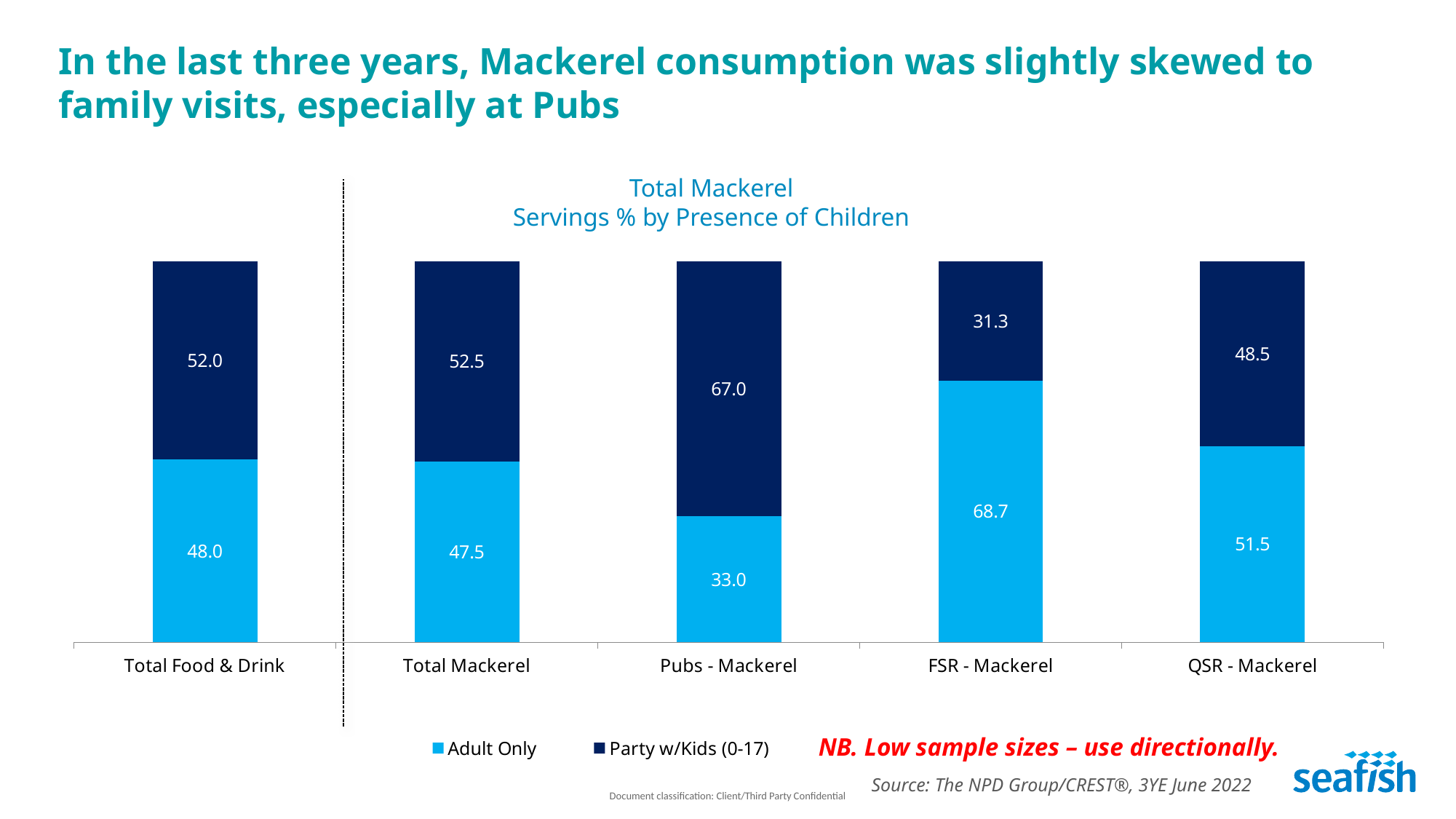
How many series does the legend list? 2 What is the Party w/Kids (0-17) value for FSR - Mackerel? 31.3 Which is larger for Total Mackerel: the Adult Only value or the Party w/Kids (0-17) value? Party w/Kids (0-17) What is the difference between the Adult Only and Party w/Kids (0-17) values for FSR - Mackerel? 37.4 What is the Adult Only value for Pubs - Mackerel? 33.0 What is the Party w/Kids (0-17) value for QSR - Mackerel? 48.5 What is the Adult Only value for Total Food & Drink? 48.0 What kind of chart is shown on the slide? Stacked bar chart Which category has the highest Party w/Kids (0-17) value? Pubs - Mackerel Which category has the lowest Adult Only value? Pubs - Mackerel How many categories are shown on the x axis? 5 What is the total of the stacked bar for QSR - Mackerel? 100.0